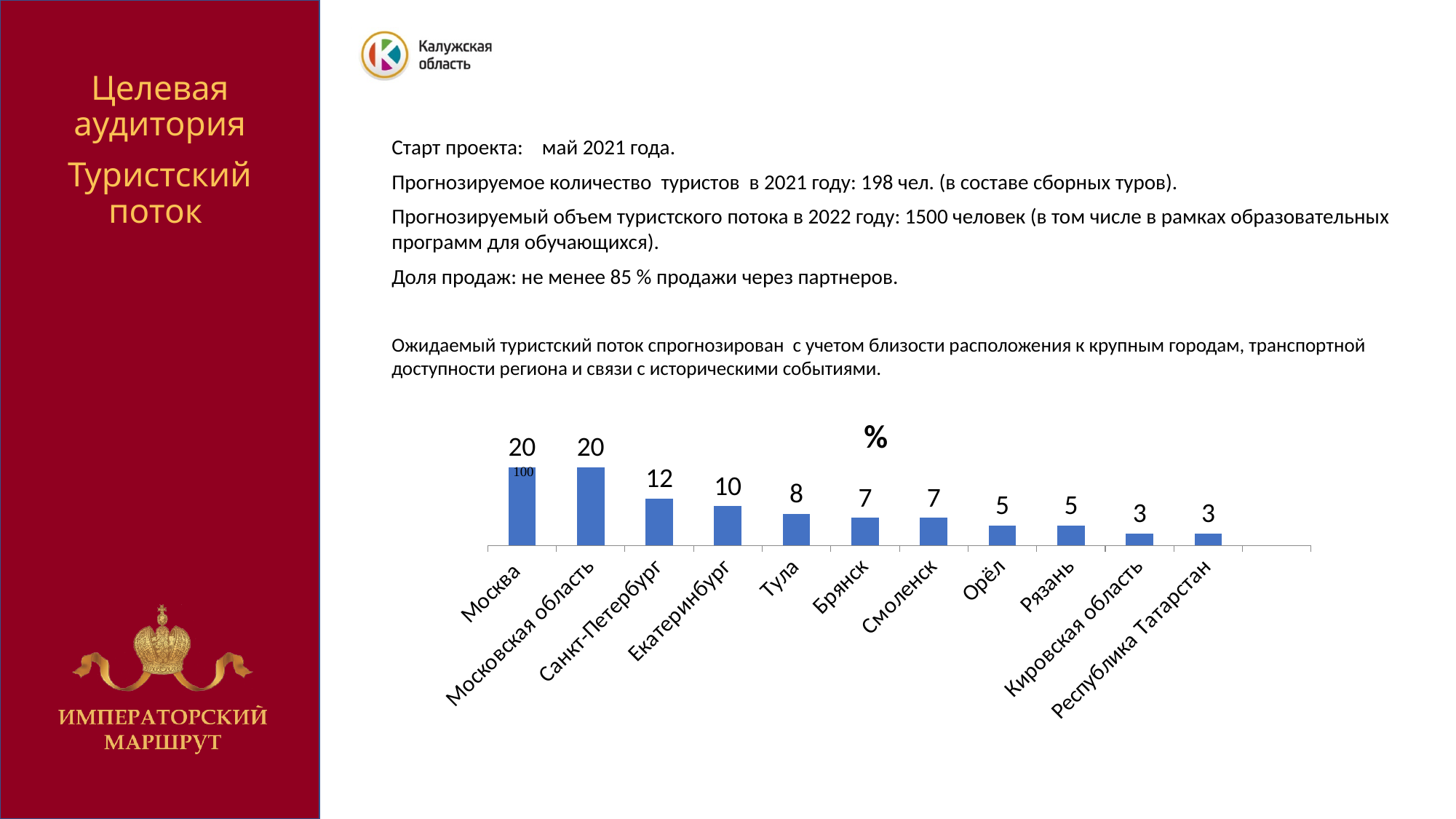
Which has the larger value, Екатеринбург or Рязань? Екатеринбург Which has the larger value, Смоленск or Кировская область? Смоленск What value is shown for Тула in the chart? 8 What value is shown for Москва in the chart? 20 What value is shown for Екатеринбург in the chart? 10 What is the difference between the values for Санкт-Петербург and Брянск? 5 What is the title of the chart? % What value is shown for Санкт-Петербург in the chart? 12 What kind of chart is shown on the slide? Bar chart What value is shown for Республика Татарстан in the chart? 3 How many categories are shown in the chart? 11 What is the difference between the values for Москва and Орёл? 15